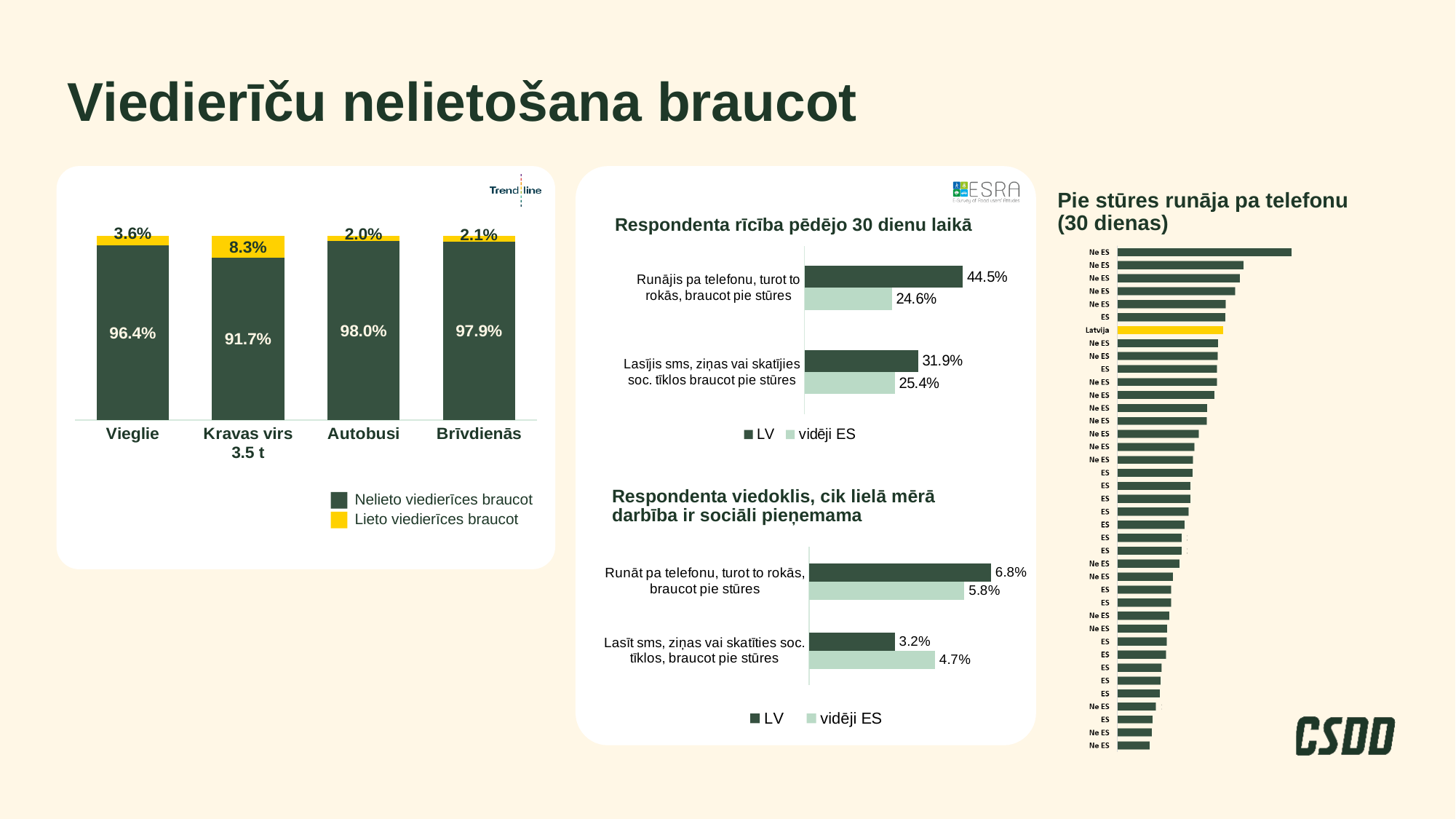
In the chart 'Respondenta rīcība pēdējo 30 dienu laikā', how many series does the legend list? 2 In the left stacked bar chart, what is the 'Nelieto viedierīces braucot' value for Vieglie? 96.4% What kind of chart is 'Pie stūres runāja pa telefonu (30 dienas)' on the right of the slide? Bar chart In the chart 'Respondenta viedoklis, cik lielā mērā darbība ir sociāli pieņemama', what is the vidēji ES value for 'Runāt pa telefonu, turot to rokās, braucot pie stūres'? 5.8% In the chart 'Respondenta rīcība pēdējo 30 dienu laikā', what is the LV value for 'Runājis pa telefonu, turot to rokās, braucot pie stūres'? 44.5% In the left stacked bar chart, which category has the highest 'Lieto viedierīces braucot' share? Kravas virs 3.5 t In the chart 'Respondenta rīcība pēdējo 30 dienu laikā', what is the difference between the LV and vidēji ES values for 'Lasījis sms, ziņas vai skatījies soc. tīklos braucot pie stūres'? 6.5% In the left stacked bar chart, how many categories are shown on the x axis? 4 In the chart 'Respondenta viedoklis, cik lielā mērā darbība ir sociāli pieņemama', which is larger for 'Lasīt sms, ziņas vai skatīties soc. tīklos, braucot pie stūres': LV or vidēji ES? vidēji ES In the left stacked bar chart, what is the difference between the 'Nelieto viedierīces braucot' values for Autobusi and Brīvdienās? 0.1% In the left stacked bar chart, what is the 'Lieto viedierīces braucot' value for Kravas virs 3.5 t? 8.3% In the left stacked bar chart, which category has the lowest 'Nelieto viedierīces braucot' share? Kravas virs 3.5 t